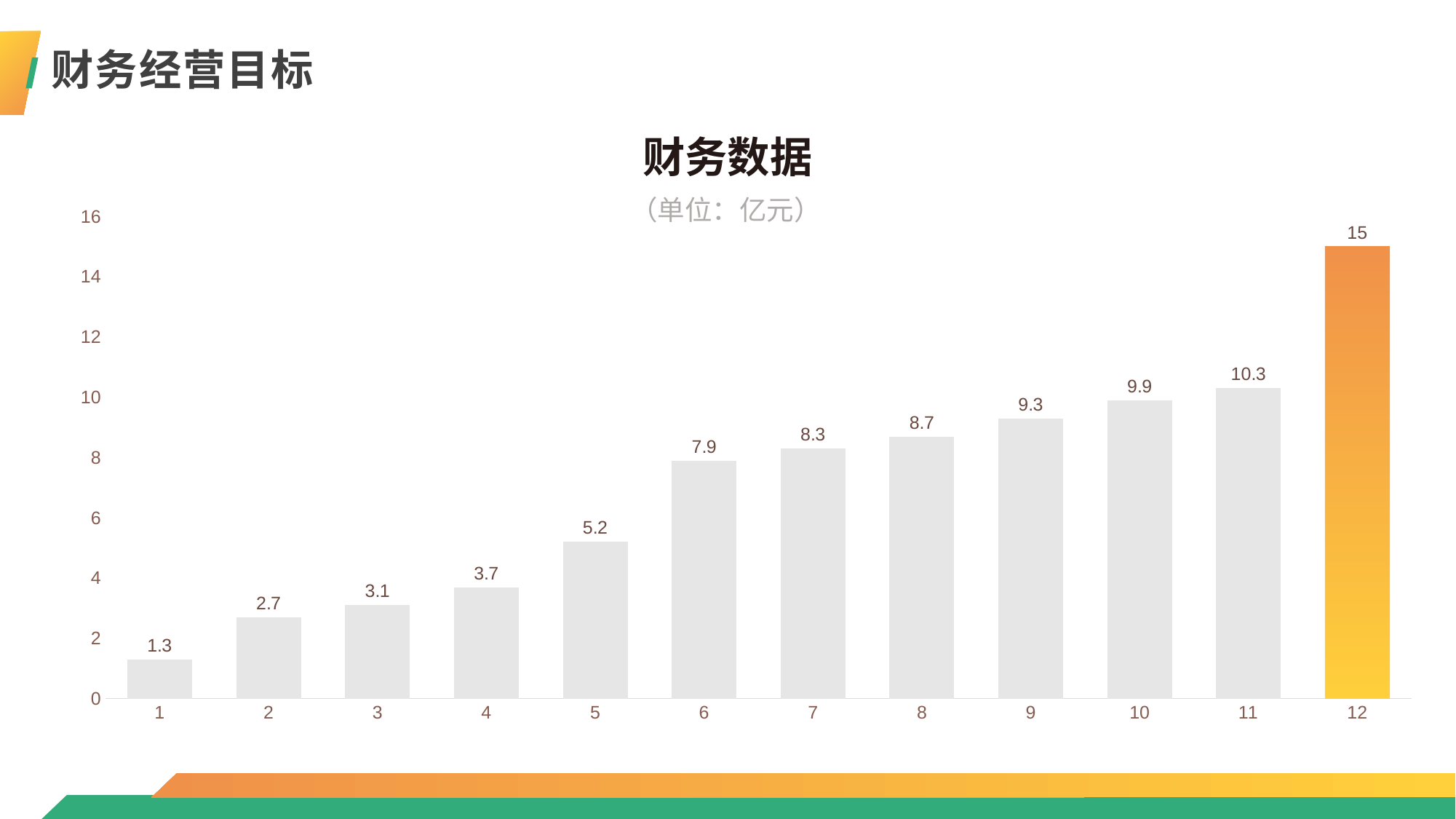
Do the values in the 财务数据 chart rise or fall from category 1 to category 12? rise Which category has the lowest value in the 财务数据 chart? 1 What is the value for category 8 in the 财务数据 chart? 8.7 What unit is stated below the title of the 财务数据 chart? 亿元 What is the difference between the values for category 6 and category 4 in the 财务数据 chart? 4.2 What is the difference between the values for category 12 and category 11 in the 财务数据 chart? 4.7 What is the value for category 12 in the 财务数据 chart? 15 What is the value for category 5 in the 财务数据 chart? 5.2 What kind of chart is the 财务数据 chart? bar chart Which is larger in the 财务数据 chart, the value for category 3 or category 7? 7 How many categories are shown on the x axis of the 财务数据 chart? 12 Which category has the highest value in the 财务数据 chart? 12